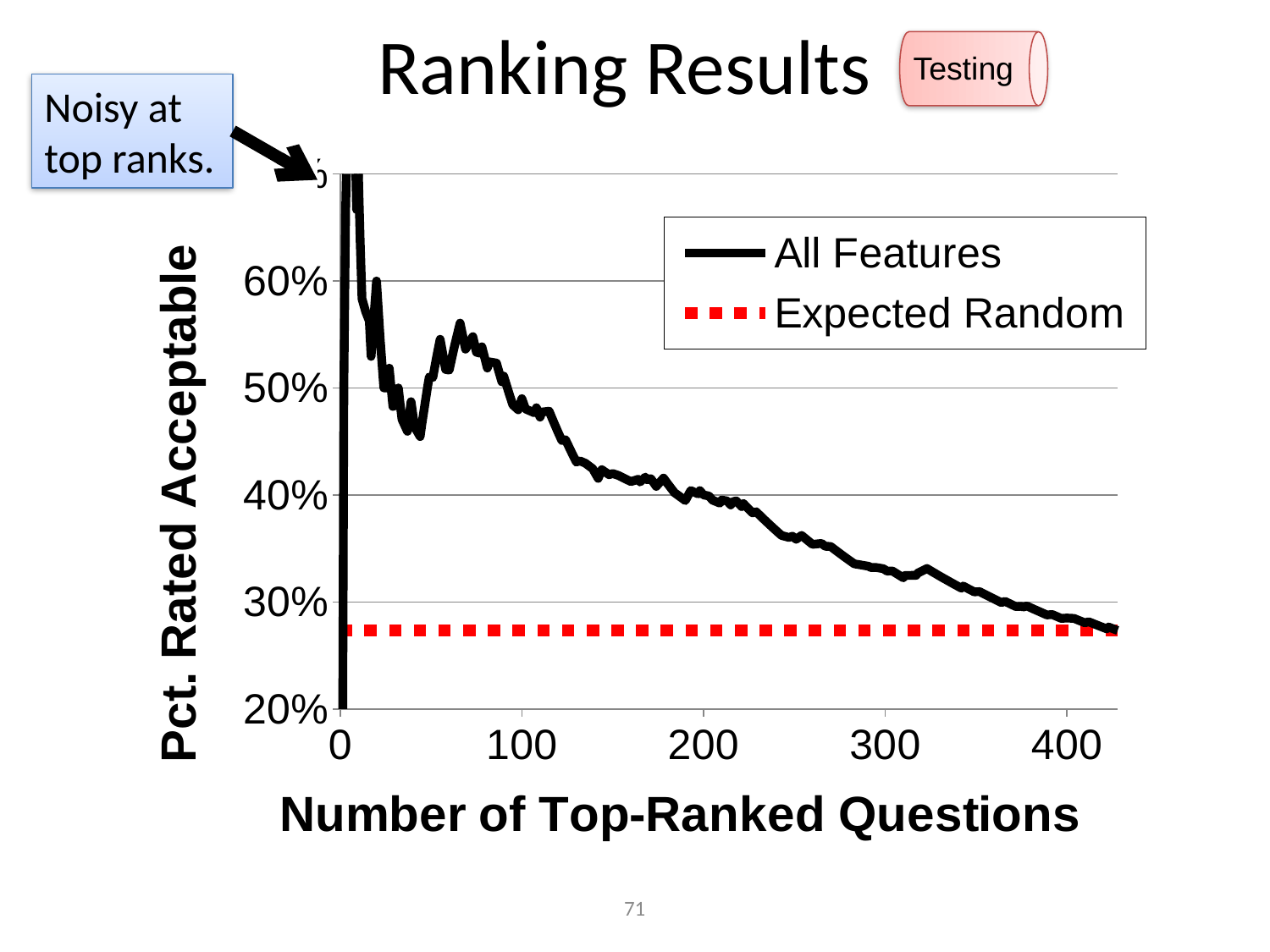
How many series does the legend list? 2 What is the title of the chart? Ranking Results Which series is drawn as a red dashed line? Expected Random What kind of chart is shown on the slide? line chart At 100 top-ranked questions, which series has the larger value, All Features or Expected Random? All Features Is the All Features value at 300 top-ranked questions greater or less than 30%? greater Is the Expected Random value greater or less than 30%? less Is the All Features value at 400 top-ranked questions greater or less than 30%? less Does the All Features line generally rise or fall as the number of top-ranked questions increases from 100 to 400? fall What is the label of the y axis? Pct. Rated Acceptable